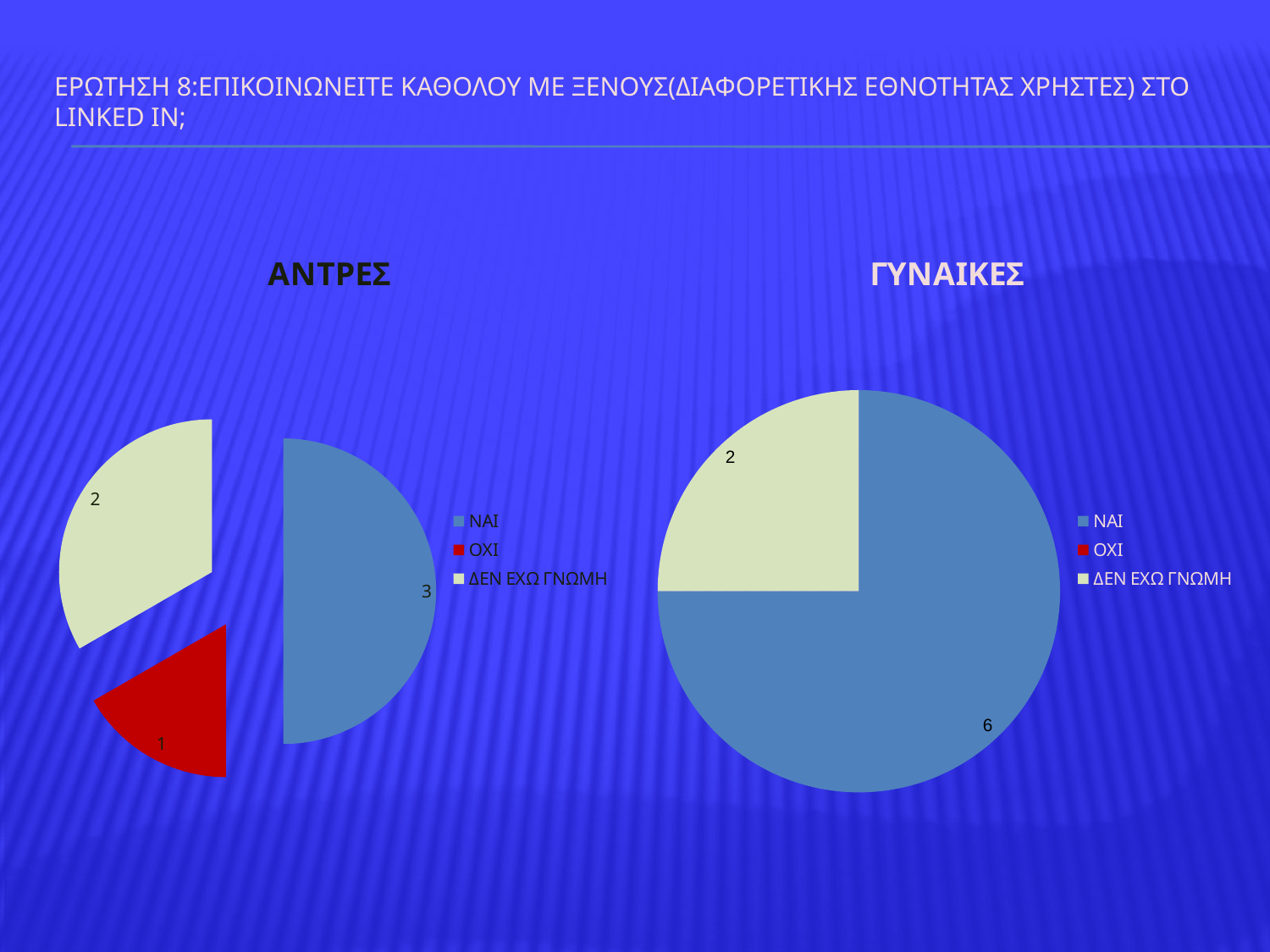
In the ΓΥΝΑΙΚΕΣ chart, what is the difference between the ΝΑΙ and ΔΕΝ ΕΧΩ ΓΝΩΜΗ values? 4 In the ΑΝΤΡΕΣ chart, what is the value for ΔΕΝ ΕΧΩ ΓΝΩΜΗ? 2 How many entries does the legend of the ΑΝΤΡΕΣ chart list? 3 In the ΑΝΤΡΕΣ chart, what is the value for ΝΑΙ? 3 In the ΑΝΤΡΕΣ chart, which category has the smallest slice? ΟΧΙ In the ΑΝΤΡΕΣ chart, what is the value for ΟΧΙ? 1 What type of chart is the ΓΥΝΑΙΚΕΣ chart? Pie chart Which chart has the larger value for ΝΑΙ, ΑΝΤΡΕΣ or ΓΥΝΑΙΚΕΣ? ΓΥΝΑΙΚΕΣ In the ΓΥΝΑΙΚΕΣ chart, what is the value for ΔΕΝ ΕΧΩ ΓΝΩΜΗ? 2 In the ΑΝΤΡΕΣ chart, what is the difference between the ΝΑΙ and ΟΧΙ values? 2 In the ΓΥΝΑΙΚΕΣ chart, what is the value for ΝΑΙ? 6 In the ΑΝΤΡΕΣ chart, which category has the largest slice? ΝΑΙ